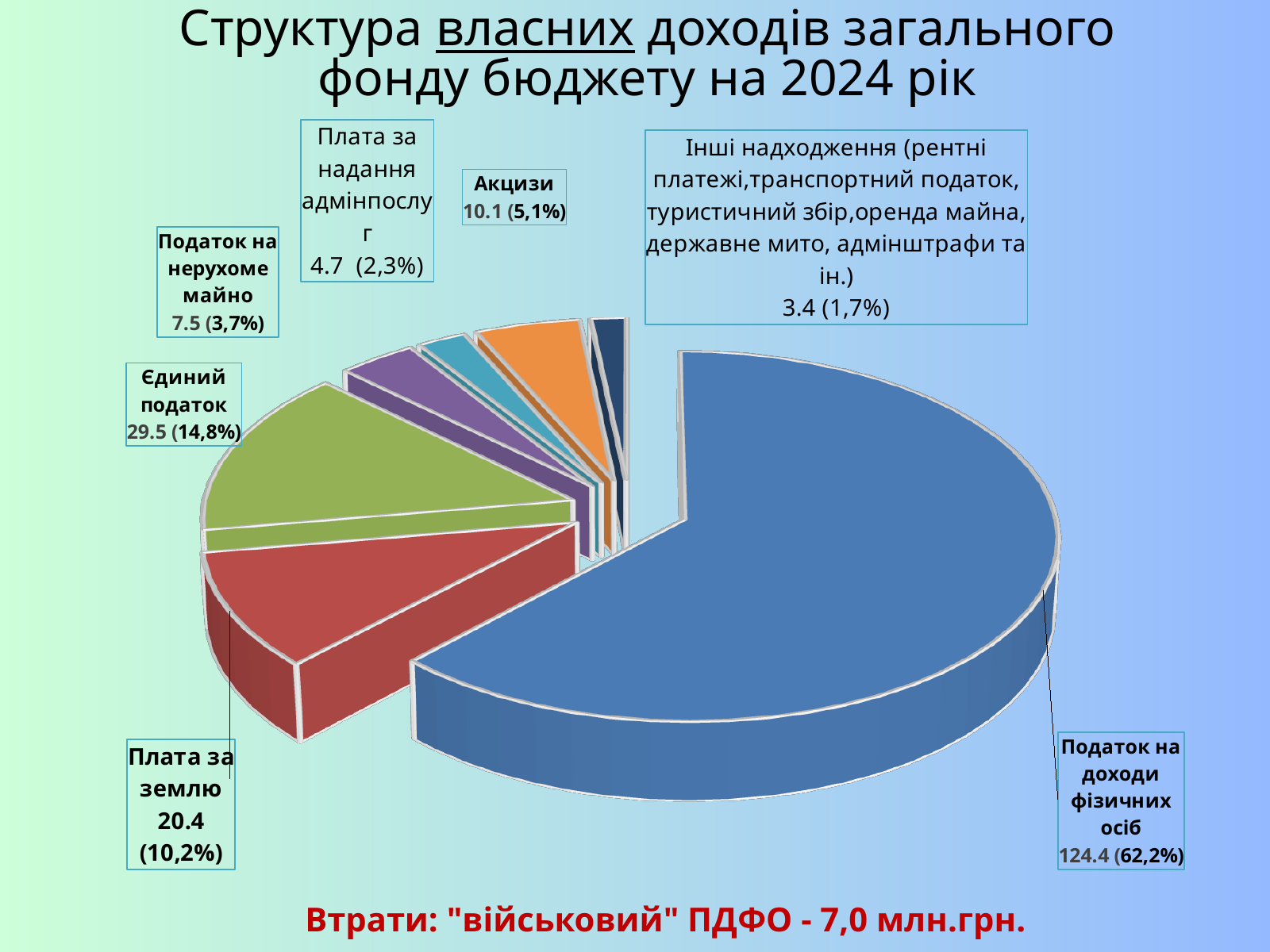
What is the title of the chart on the slide? Структура власних доходів загального фонду бюджету на 2024 рік What share of the pie does "Податок на нерухоме майно" represent? 3,7% What is the value shown for "Акцизи"? 10.1 (5,1%) What type of chart is shown on the slide? pie chart What is the difference between the values for "Єдиний податок" and "Плата за землю"? 9.1 Which is larger, "Єдиний податок" or "Плата за землю"? Єдиний податок Which category has the smallest slice of the pie? Інші надходження What is the value shown for "Єдиний податок"? 29.5 (14,8%) What is the value shown for "Податок на доходи фізичних осіб"? 124.4 (62,2%) What share of the pie does "Плата за землю" represent? 10,2% Which category has the largest slice of the pie? Податок на доходи фізичних осіб How many slices does the pie chart have? 7